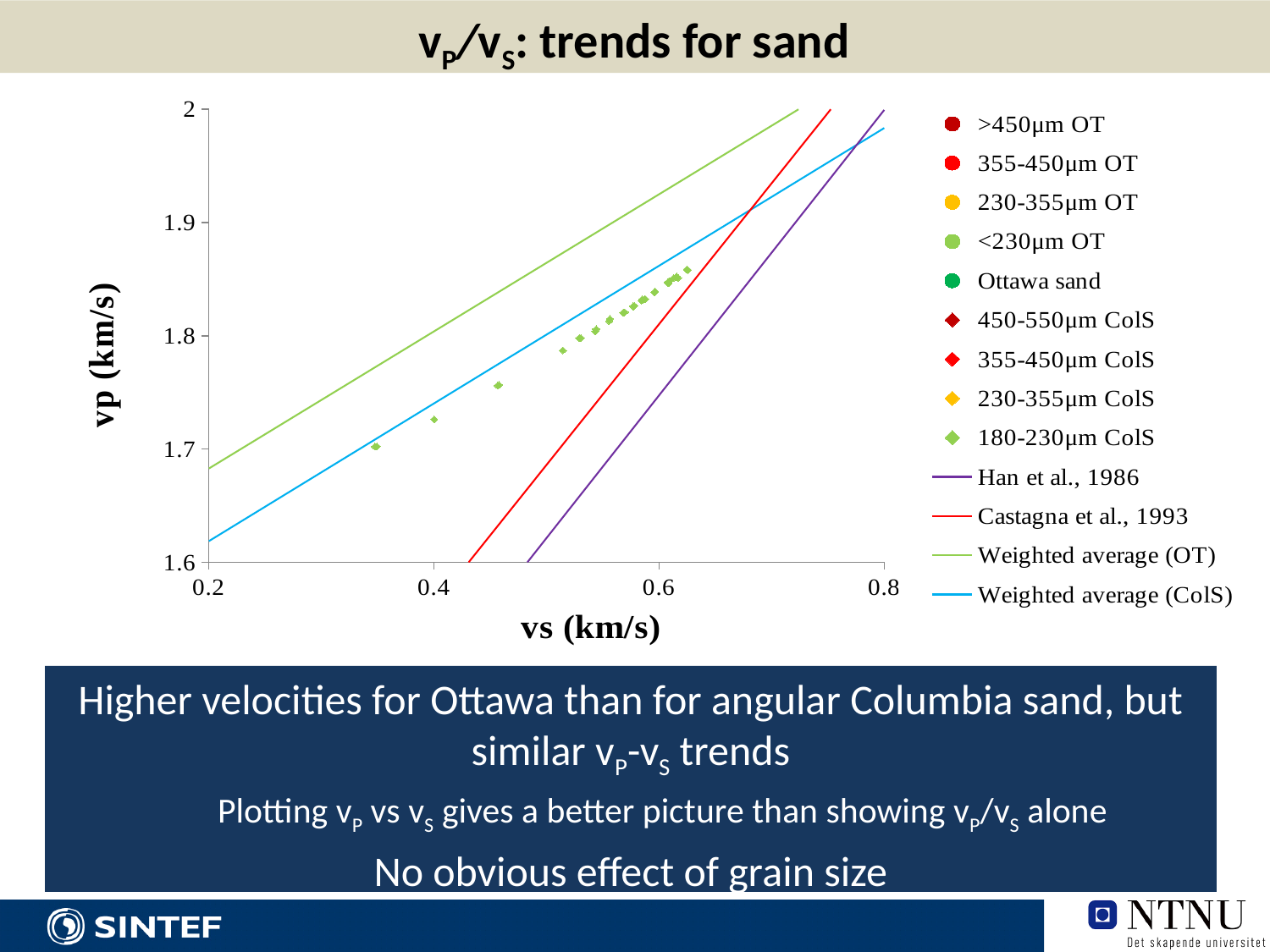
What is the title of the chart's x axis? vs (km/s) Is the value of the Weighted average (OT) line at vs = 0.6 greater or less than 1.9? greater At vs = 0.6, which line is higher: Weighted average (OT) or Han et al., 1986? Weighted average (OT) How many entries does the chart legend list? 13 Which line reaches vp = 2 at the smallest value of vs? Weighted average (OT) Do the plotted data points rise or fall as vs increases? rise What is the title of the chart's y axis? vp (km/s) What kind of chart is shown on the slide? scatter chart Is the value of the Castagna et al., 1993 line at vs = 0.7 greater or less than 1.9? greater Is the value of the Han et al., 1986 line at vs = 0.6 greater or less than 1.8? less How many line series (trend lines) does the legend list? 4